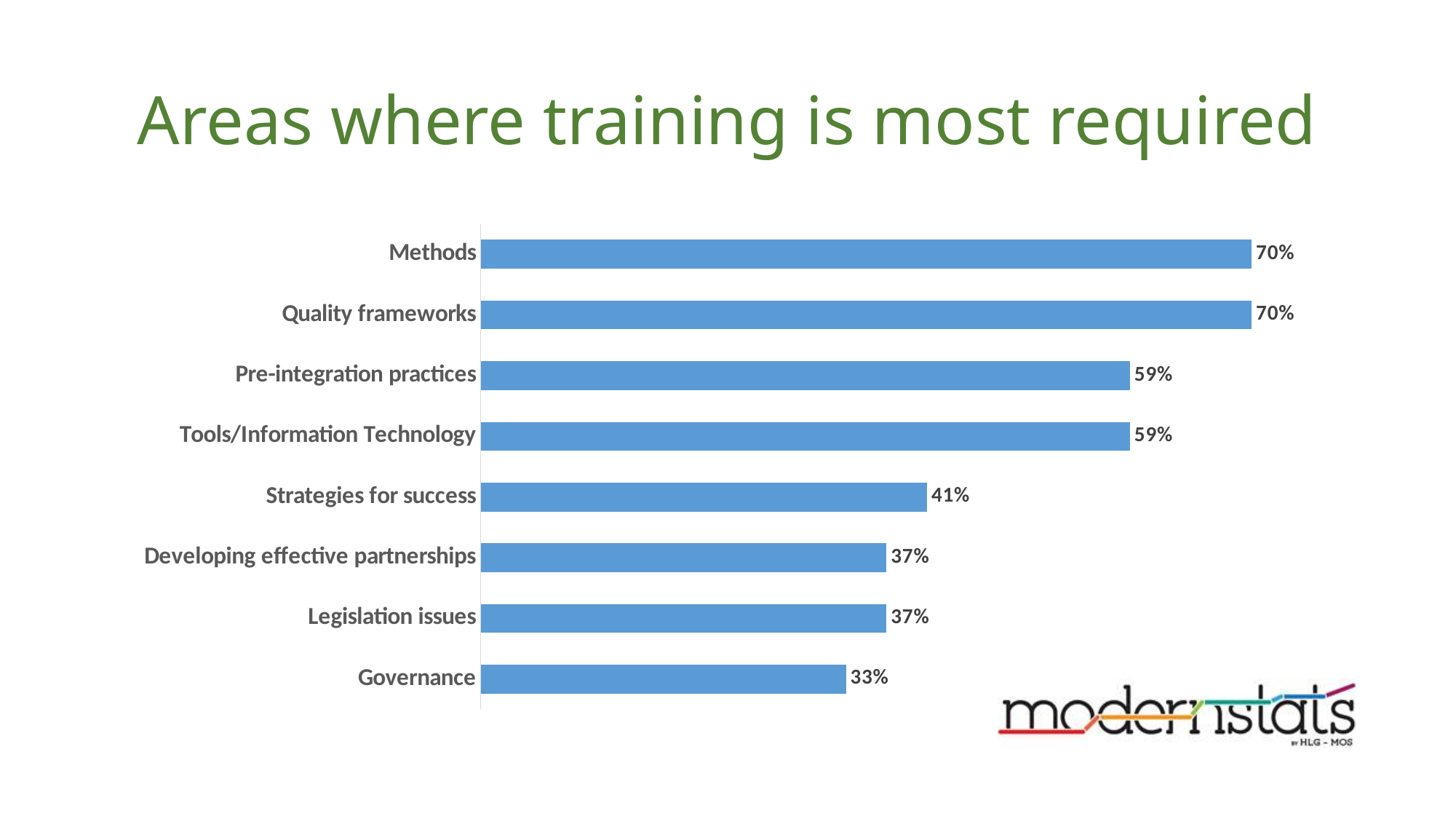
What is the value for Legislation issues? 37% What is the value for Pre-integration practices? 59% What is the difference between the values for Tools/Information Technology and Strategies for success? 18% Which is larger, the value for Quality frameworks or the value for Developing effective partnerships? Quality frameworks What is the difference between the values for Methods and Governance? 37% What colour are the bars in the chart? Blue Which category has the lowest value? Governance What is the title of the slide? Areas where training is most required What is the value for Methods? 70% What is the value for Strategies for success? 41% What kind of chart is shown on the slide? Bar chart How many categories are shown in the chart? 8